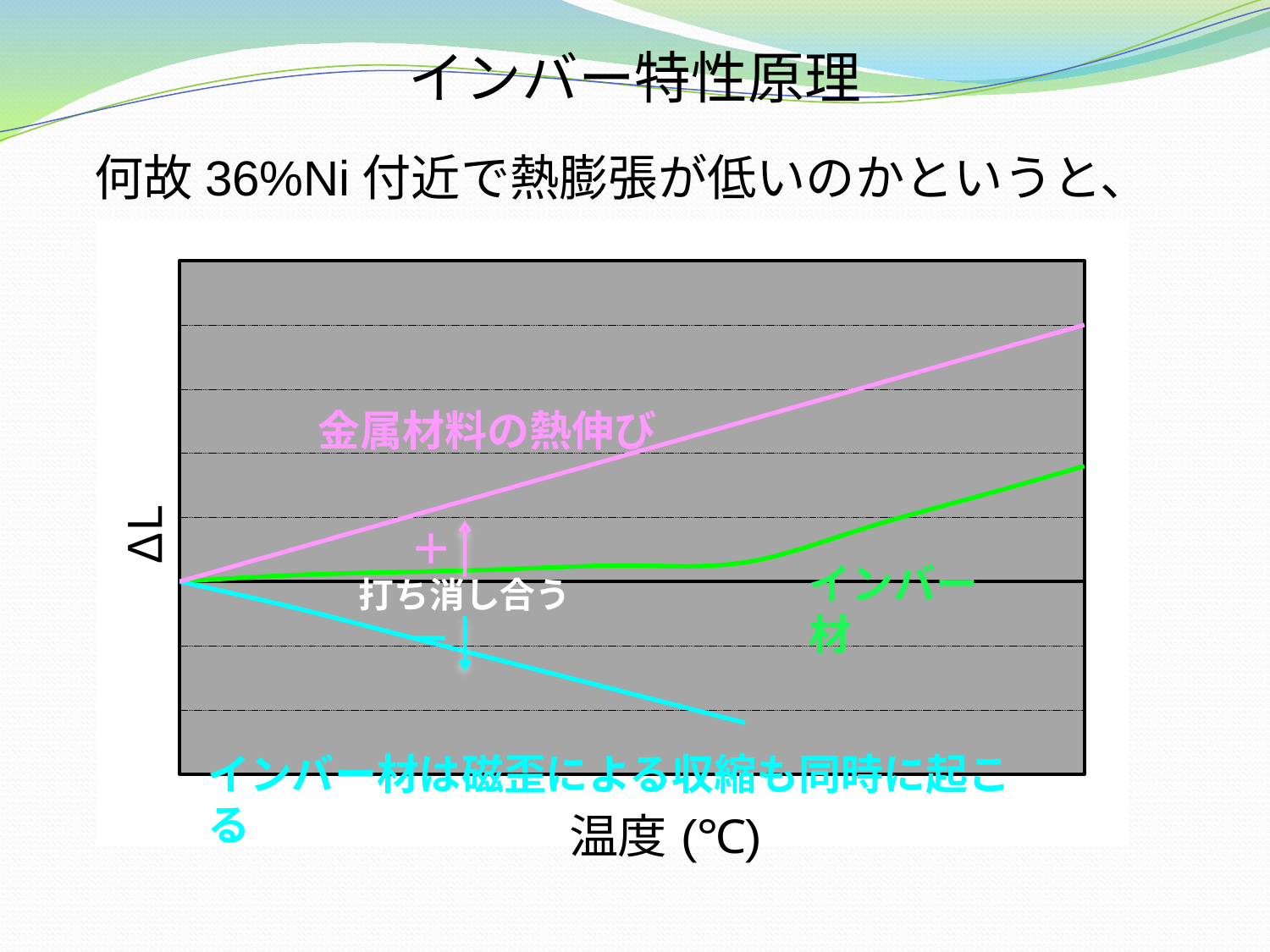
Which line is highest at the right end of the chart: 金属材料の熱伸び or インバー材? 金属材料の熱伸び Does the cyan line (インバー材は磁歪による収縮も同時に起こる) rise or fall as temperature increases? fall What kind of chart is shown on the slide? line chart Which line reaches the highest ΔL value in the chart? 金属材料の熱伸び Does the pink line labelled 金属材料の熱伸び rise or fall as temperature increases? rise What is the label of the y axis of the chart? ΔL What is the label of the x axis of the chart? 温度 (℃) How many lines (series) are plotted in the chart? 3 Does the green line labelled インバー材 rise or fall overall as temperature increases? rise Which line reaches the lowest ΔL value in the chart? the cyan line (インバー材は磁歪による収縮も同時に起こる)